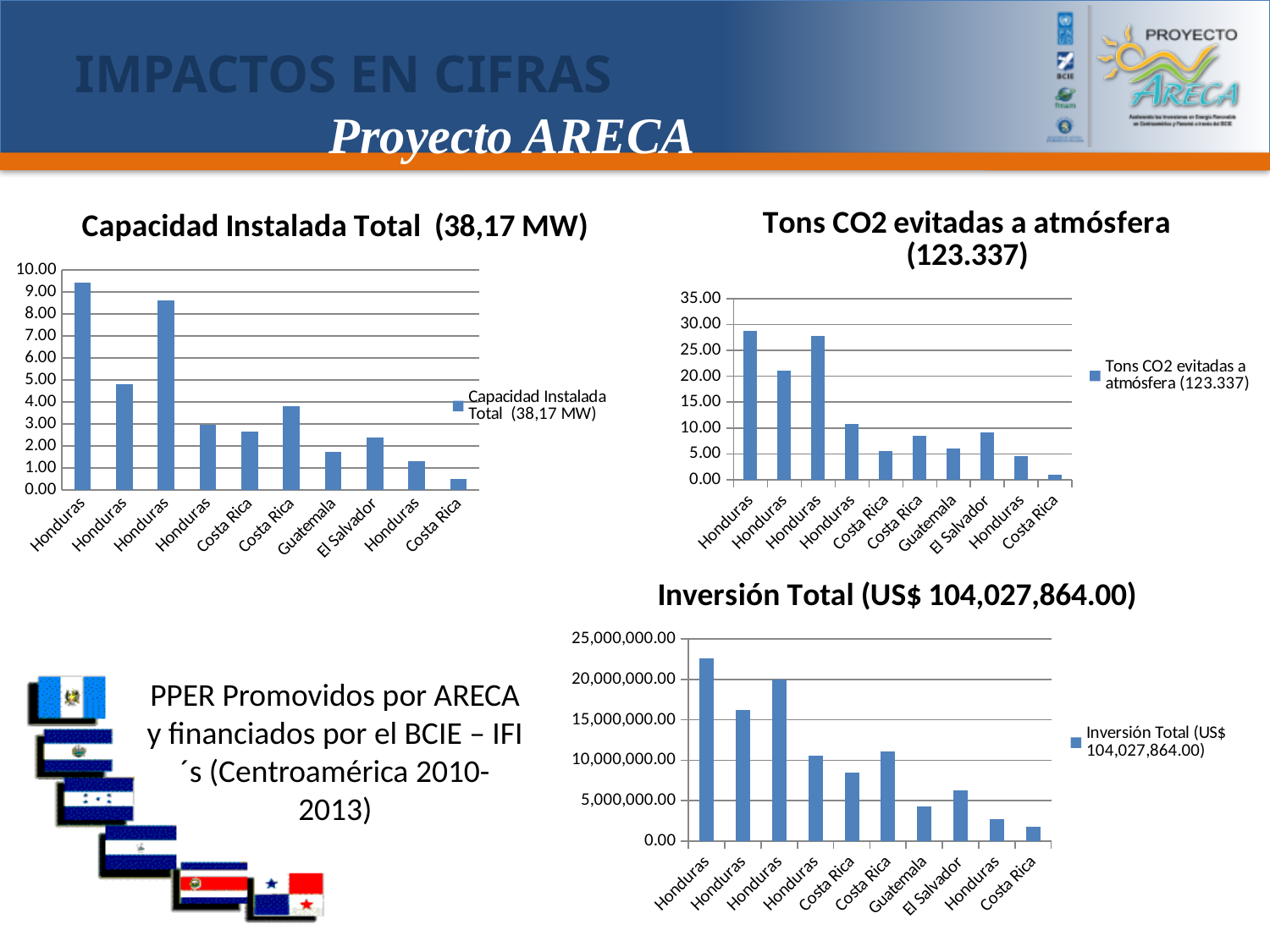
What type of chart is the 'Capacidad Instalada Total (38,17 MW)' chart? bar chart In the 'Tons CO2 evitadas a atmósfera (123.337)' chart, is the value for El Salvador greater or less than 10.00? less In the 'Tons CO2 evitadas a atmósfera (123.337)' chart, how many series does the legend list? 1 In the 'Tons CO2 evitadas a atmósfera (123.337)' chart, which is larger, the value for Guatemala or the value for El Salvador? El Salvador What is the title of the chart at the bottom right of the slide? Inversión Total (US$ 104,027,864.00) In the 'Capacidad Instalada Total (38,17 MW)' chart, how many bars are plotted? 10 In the 'Capacidad Instalada Total (38,17 MW)' chart, which is larger, the value for Guatemala or the value for El Salvador? El Salvador In the 'Capacidad Instalada Total (38,17 MW)' chart, is the value for Guatemala greater or less than 2.00? less In the 'Inversión Total (US$ 104,027,864.00)' chart, is the value for El Salvador greater or less than 5,000,000.00? greater In the 'Inversión Total (US$ 104,027,864.00)' chart, which category has the highest bar? Honduras (first bar) In the 'Capacidad Instalada Total (38,17 MW)' chart, which category has the lowest bar? Costa Rica (last bar)